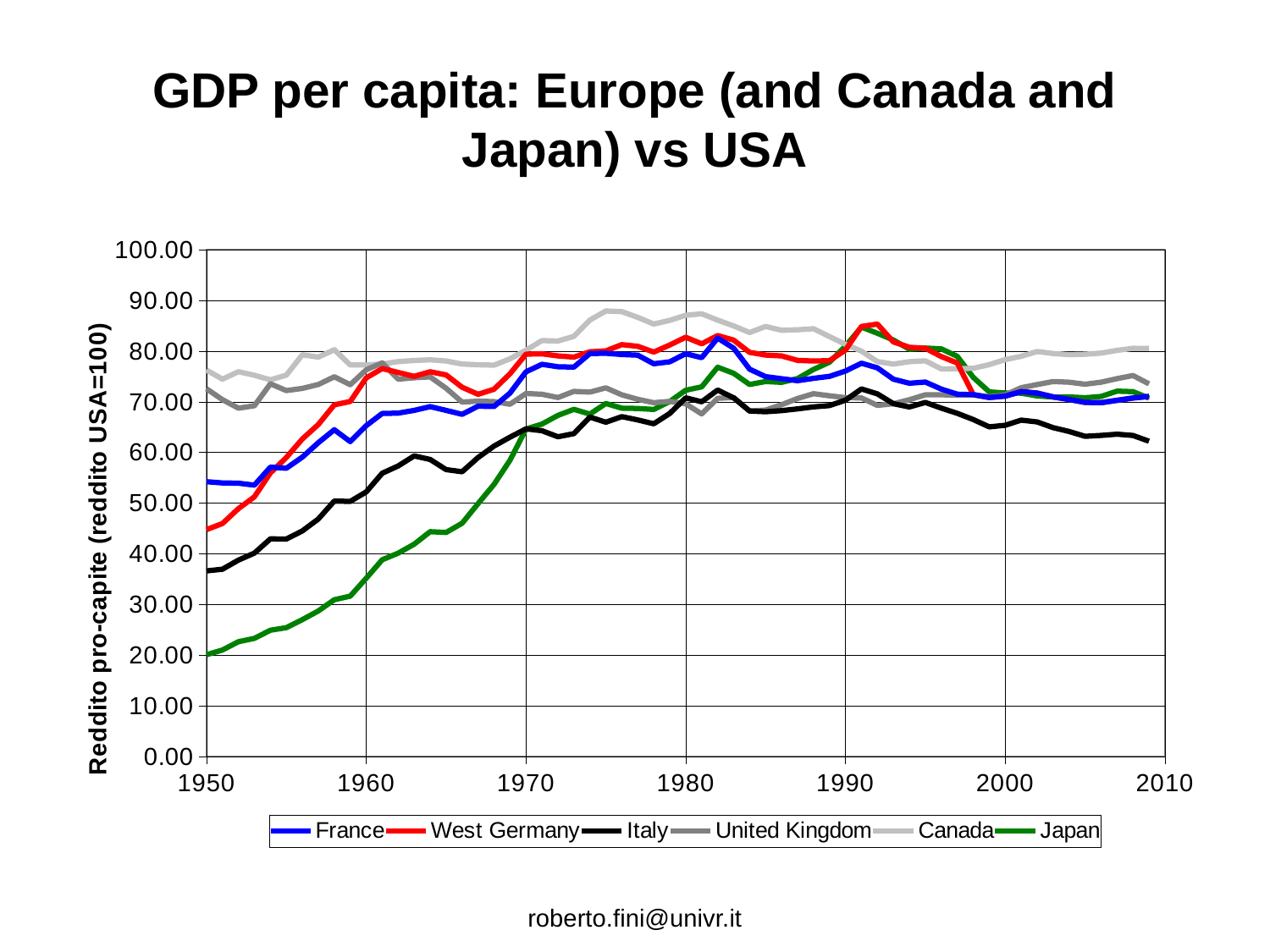
Does the value for Japan rise or fall between 1950 and 1970? rise Is the value for Italy in 1950 greater or less than 40? less Is the value for Japan in 1950 greater or less than 30? less What kind of chart is shown on the slide? line chart Which country has the highest value in 1950? Canada How many series does the legend list? 6 Which country has the lowest value in 1950? Japan Is the value for France in 1950 greater or less than 50? greater What is the title of the vertical axis? Reddito pro-capite (reddito USA=100) In 1950, which is larger: the value for France or the value for West Germany? France Does the value for Italy rise or fall between 1990 and 2010? fall